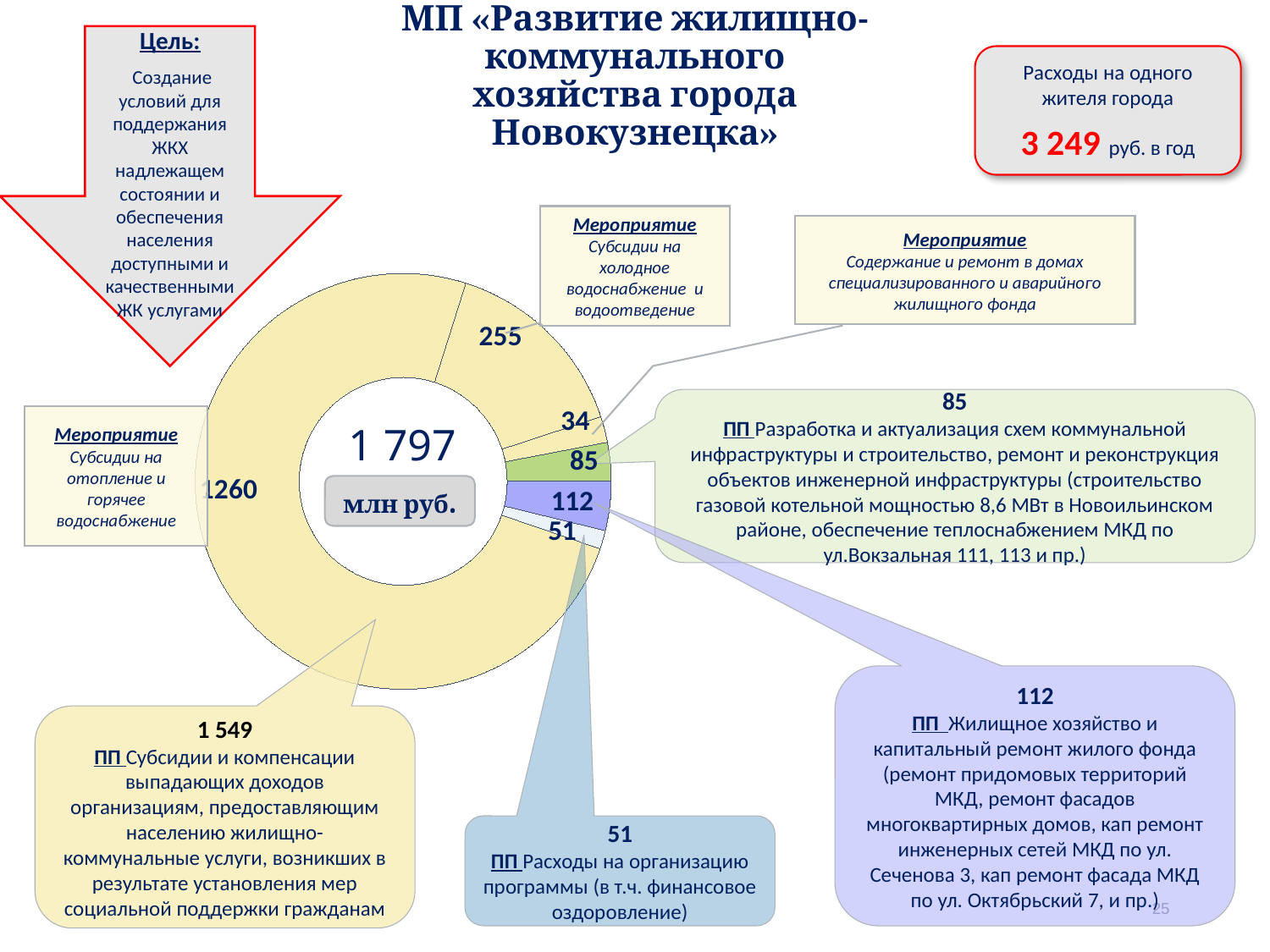
What colour is the segment with value 85 in the doughnut chart? Green What is the value of the segment for «Субсидии на холодное водоснабжение и водоотведение»? 255 What is the value of the segment for «ПП Расходы на организацию программы»? 51 What is the combined value of the 85, 112 and 51 segments? 248 What kind of chart is shown on the slide? Doughnut (pie) chart What is the difference between the 1260 segment and the 255 segment? 1005 What total value is printed in the centre of the doughnut chart? 1 797 млн руб. Which segment of the doughnut chart has the largest value? 1260 (Субсидии на отопление и горячее водоснабжение) What is the value of the segment for «ПП Жилищное хозяйство и капитальный ремонт жилого фонда»? 112 Which is larger: the segment for «ПП Разработка и актуализация схем коммунальной инфраструктуры» (85) or the segment for «ПП Жилищное хозяйство и капитальный ремонт жилого фонда» (112)? ПП Жилищное хозяйство и капитальный ремонт жилого фонда (112) Which segment of the doughnut chart has the smallest value? 34 (Содержание и ремонт в домах специализированного и аварийного жилищного фонда) How many segments does the doughnut chart have? 6